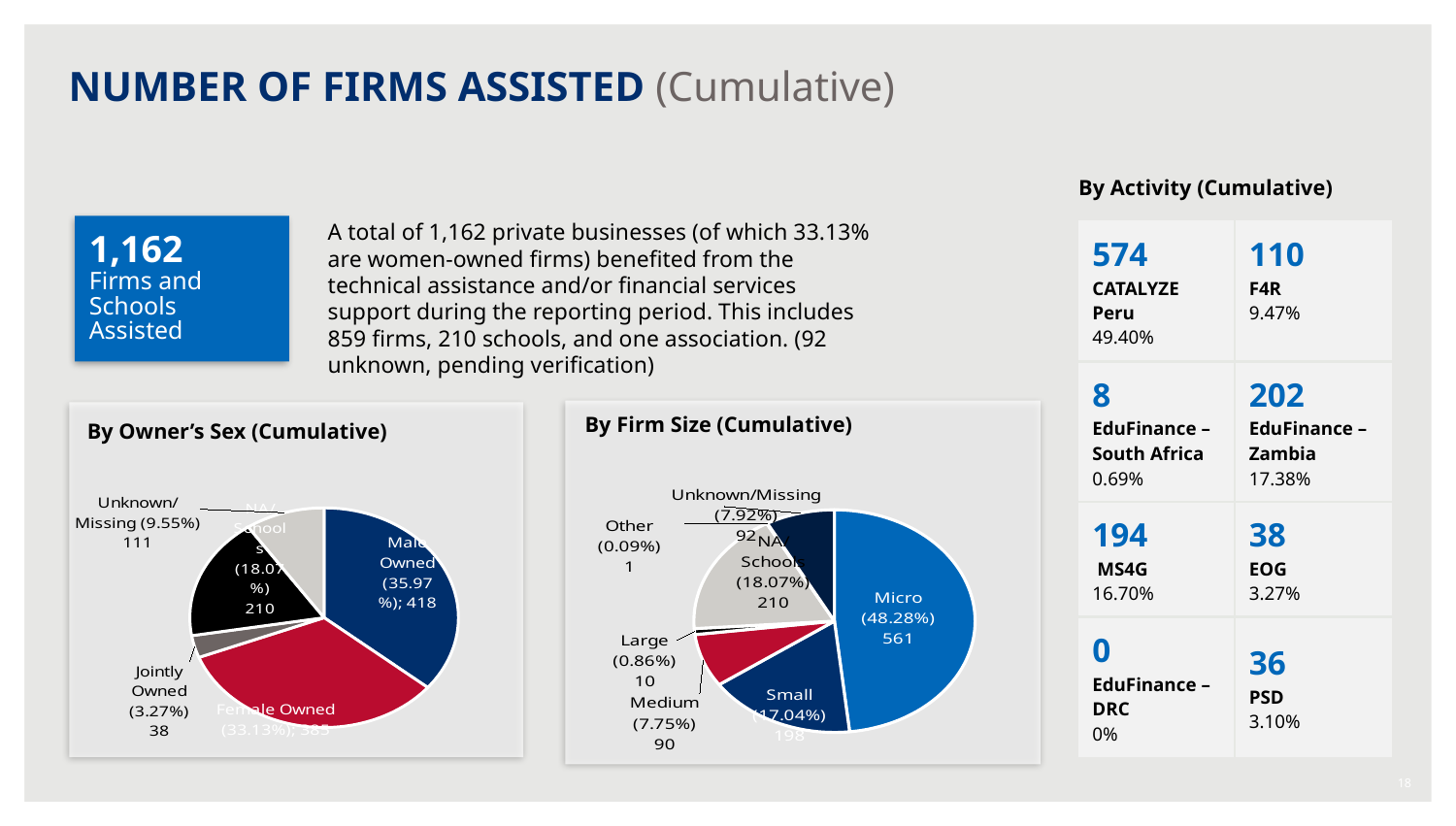
In the 'By Owner's Sex (Cumulative)' chart, what is the number of Male Owned firms? 418 In the 'By Firm Size (Cumulative)' chart, what is the difference between the Medium count and the Large count? 80 In the 'By Owner's Sex (Cumulative)' chart, how many firms are Jointly Owned? 38 In the 'By Firm Size (Cumulative)' chart, which category has the largest slice? Micro What kind of chart is 'By Firm Size (Cumulative)'? Pie chart In the 'By Firm Size (Cumulative)' chart, which is larger, the Large count or the Unknown/Missing count? Unknown/Missing In the 'By Owner's Sex (Cumulative)' chart, what is the difference between the Unknown/Missing count and the Jointly Owned count? 73 In the 'By Firm Size (Cumulative)' chart, how many Micro firms are there? 561 In the 'By Owner's Sex (Cumulative)' chart, what is the percentage share of Unknown/Missing? 9.55% In the 'By Firm Size (Cumulative)' chart, what is the percentage share of Medium firms? 7.75% In the 'By Owner's Sex (Cumulative)' chart, which category has the smallest slice? Jointly Owned In the 'By Owner's Sex (Cumulative)' chart, what percentage share is Female Owned? 33.13%